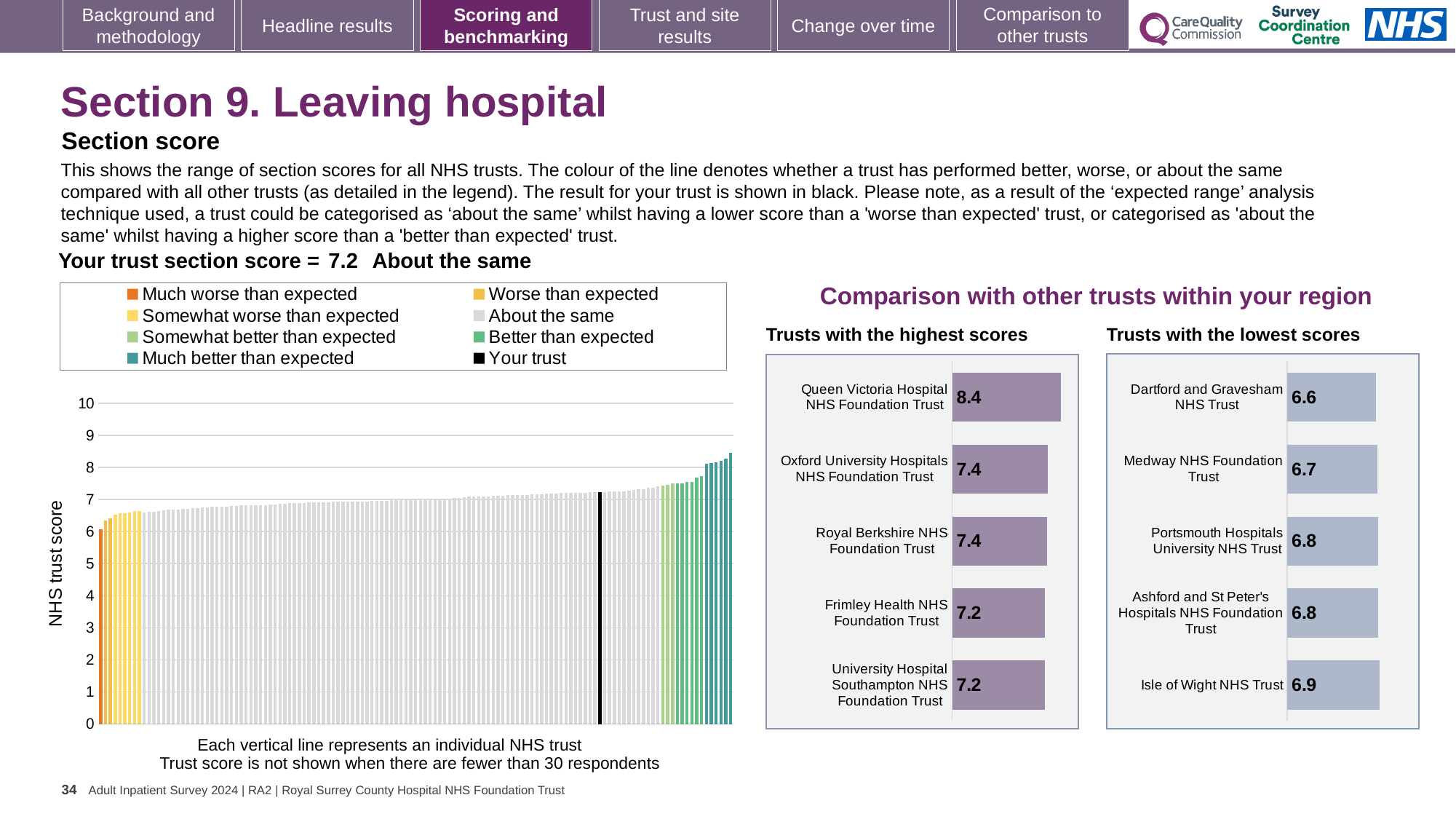
How many trusts are shown in the 'Trusts with the highest scores' chart? 5 In the main NHS trust score chart, do the trust scores rise or fall from left to right? Rise In the 'Trusts with the lowest scores' chart, what is the score for Dartford and Gravesham NHS Trust? 6.6 In the 'Trusts with the highest scores' chart, which trust has the highest score? Queen Victoria Hospital NHS Foundation Trust In the 'Trusts with the highest scores' chart, what is the score for Queen Victoria Hospital NHS Foundation Trust? 8.4 In the 'Trusts with the lowest scores' chart, what is the difference between the scores of Isle of Wight NHS Trust and Dartford and Gravesham NHS Trust? 0.3 In the main NHS trust score chart, what is the section score for your trust? 7.2 In the 'Trusts with the lowest scores' chart, which trust has the lowest score? Dartford and Gravesham NHS Trust What kind of chart is the main NHS trust score chart on the left? Bar chart In the 'Trusts with the highest scores' chart, what is the difference between the scores of Queen Victoria Hospital NHS Foundation Trust and Frimley Health NHS Foundation Trust? 1.2 In the 'Trusts with the lowest scores' chart, which has the higher score: Medway NHS Foundation Trust or Isle of Wight NHS Trust? Isle of Wight NHS Trust How many entries does the legend of the main NHS trust score chart list? 8